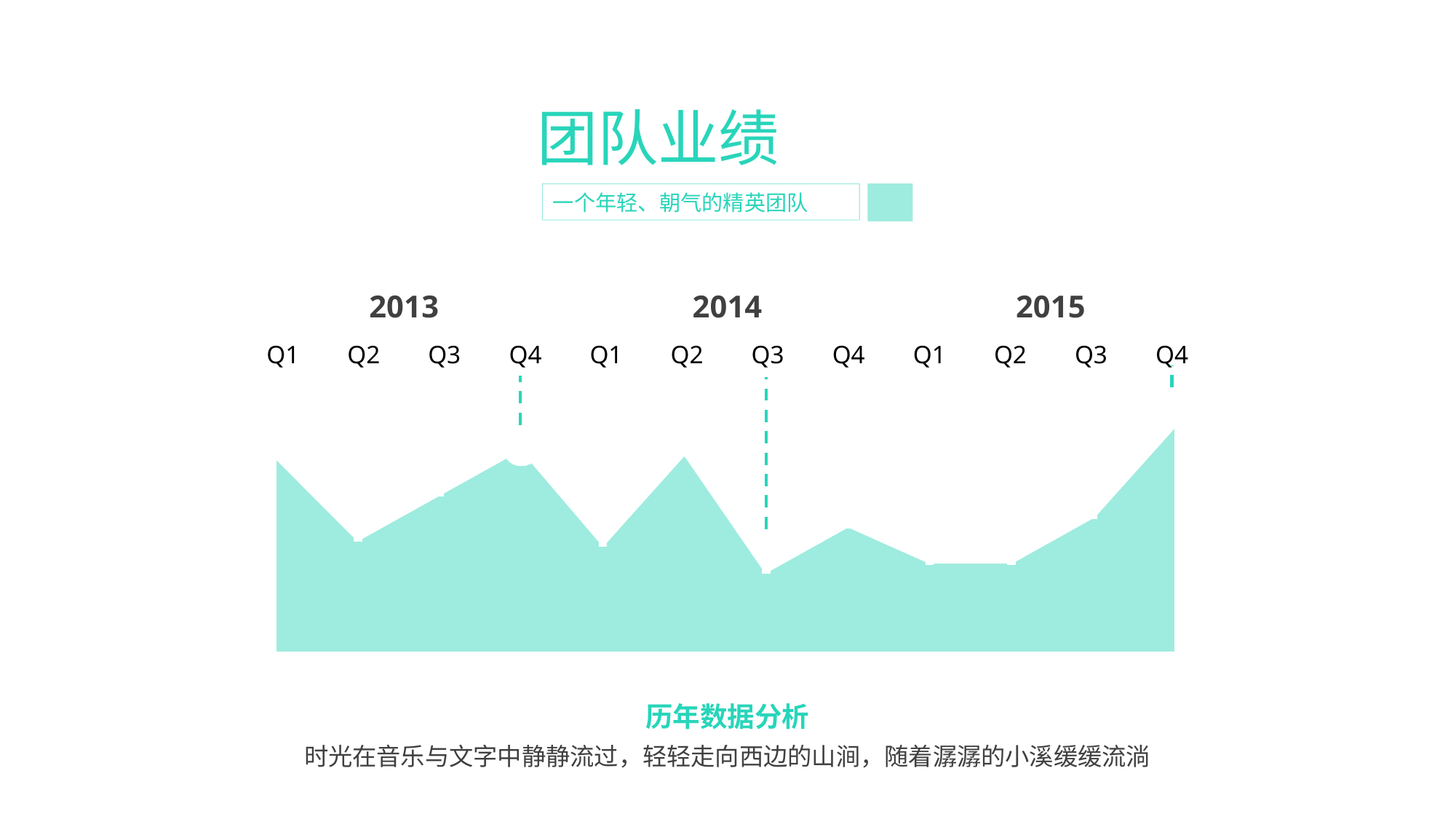
Do the values rise or fall from 2014 Q2 to 2014 Q3? Fall How many years are labelled along the top of the chart? 3 Which is larger, the value for 2013 Q1 or the value for 2013 Q2? 2013 Q1 What is the caption printed below the chart? 历年数据分析 Do the values rise or fall from 2015 Q2 to 2015 Q4? Rise How many quarterly data points are plotted on the chart? 12 Which is larger, the value for 2014 Q2 or the value for 2014 Q3? 2014 Q2 What kind of chart is shown on the slide? Area chart Do the values rise or fall from 2013 Q2 to 2013 Q4? Rise What is the title of the slide above the chart? 团队业绩 Which is larger, the value for 2015 Q1 or the value for 2015 Q4? 2015 Q4 Which quarter has the highest value on the chart? 2015 Q4